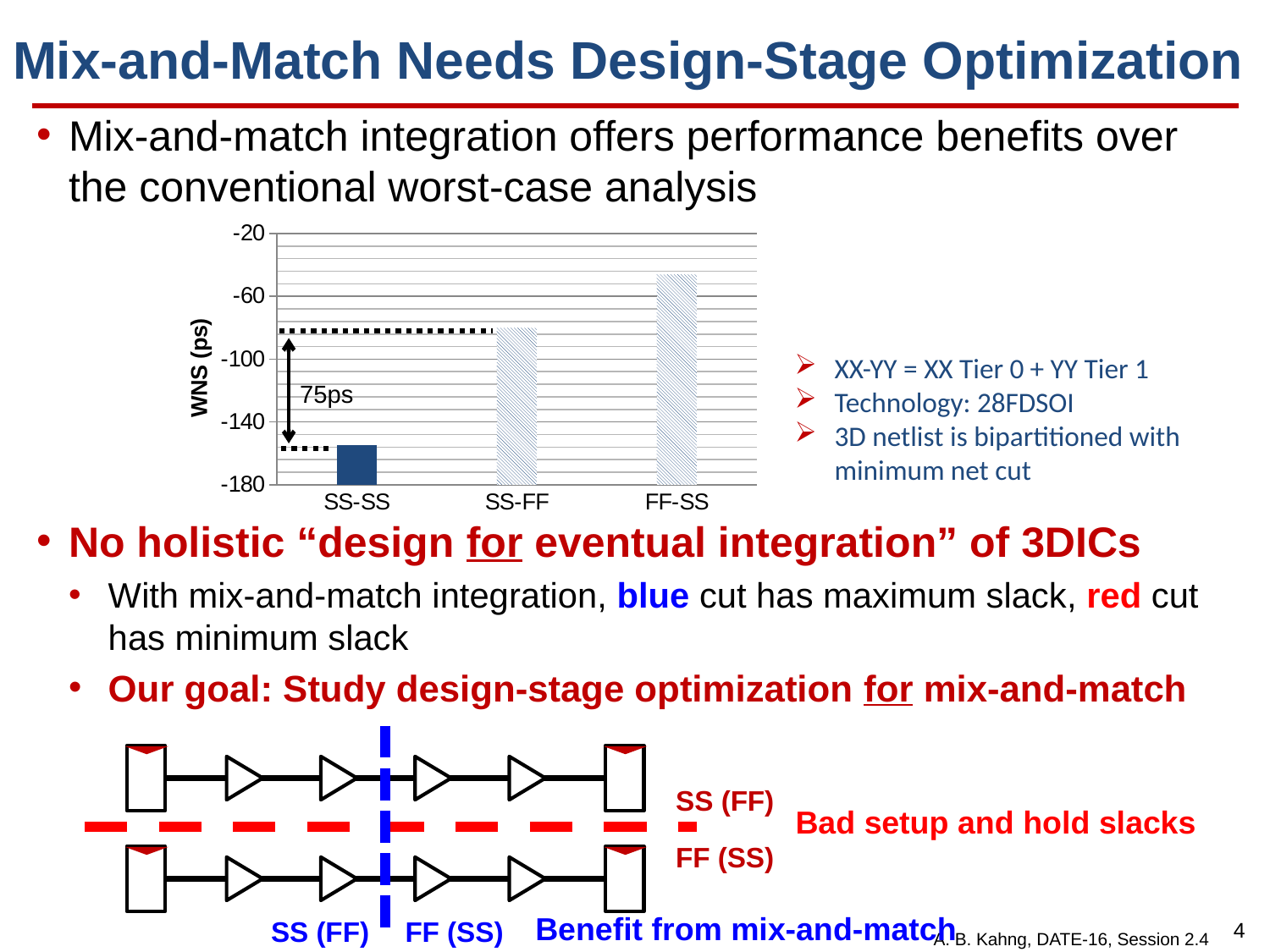
According to the annotation on the chart, what is the difference in WNS between SS-SS and SS-FF? 75ps Is the WNS value for SS-FF greater or less than -100? greater What is the label of the y axis of the chart? WNS (ps) Which category has the highest WNS value in the chart? FF-SS Is the WNS value for FF-SS greater or less than -60? greater Which has a larger WNS value, SS-FF or FF-SS? FF-SS What kind of chart is shown on the slide? bar chart How many categories are plotted on the x axis of the chart? 3 Do the WNS values rise or fall moving from SS-SS to FF-SS along the x axis? rise Which category has the lowest WNS value in the chart? SS-SS What is the lowest tick value shown on the y axis of the chart? -180 Is the WNS value for SS-SS greater or less than -140? less